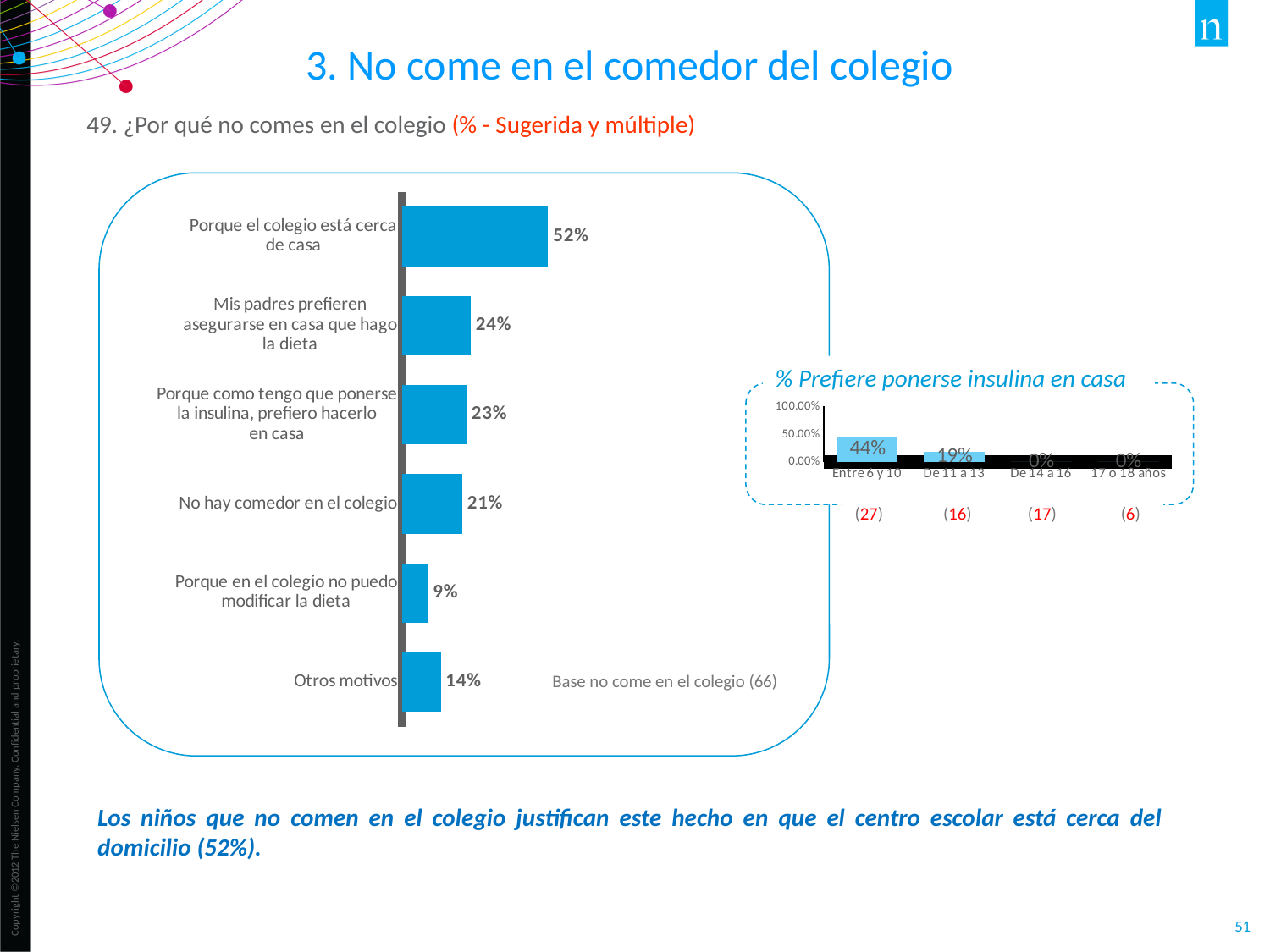
In the chart titled "% Prefiere ponerse insulina en casa", what is the value for "Entre 6 y 10"? 44% In the chart titled "% Prefiere ponerse insulina en casa", what is the value for "De 11 a 13"? 19% What type of chart is the main chart on the left? Bar chart In the main bar chart on the left, what percentage is shown for "Otros motivos"? 14% In the main bar chart on the left, which reason has the lowest percentage? Porque en el colegio no puedo modificar la dieta In the chart titled "% Prefiere ponerse insulina en casa", which age group has the highest value? Entre 6 y 10 In the main bar chart on the left, how many reasons (categories) are plotted? 6 In the main bar chart on the left, what percentage is shown for "Porque el colegio está cerca de casa"? 52% In the chart titled "% Prefiere ponerse insulina en casa", how many age groups are plotted? 4 In the main bar chart on the left, which reason has the highest percentage? Porque el colegio está cerca de casa In the main bar chart on the left, what percentage is shown for "No hay comedor en el colegio"? 21% In the main bar chart on the left, what is the difference between "Porque el colegio está cerca de casa" and "Mis padres prefieren asegurarse en casa que hago la dieta"? 28 percentage points